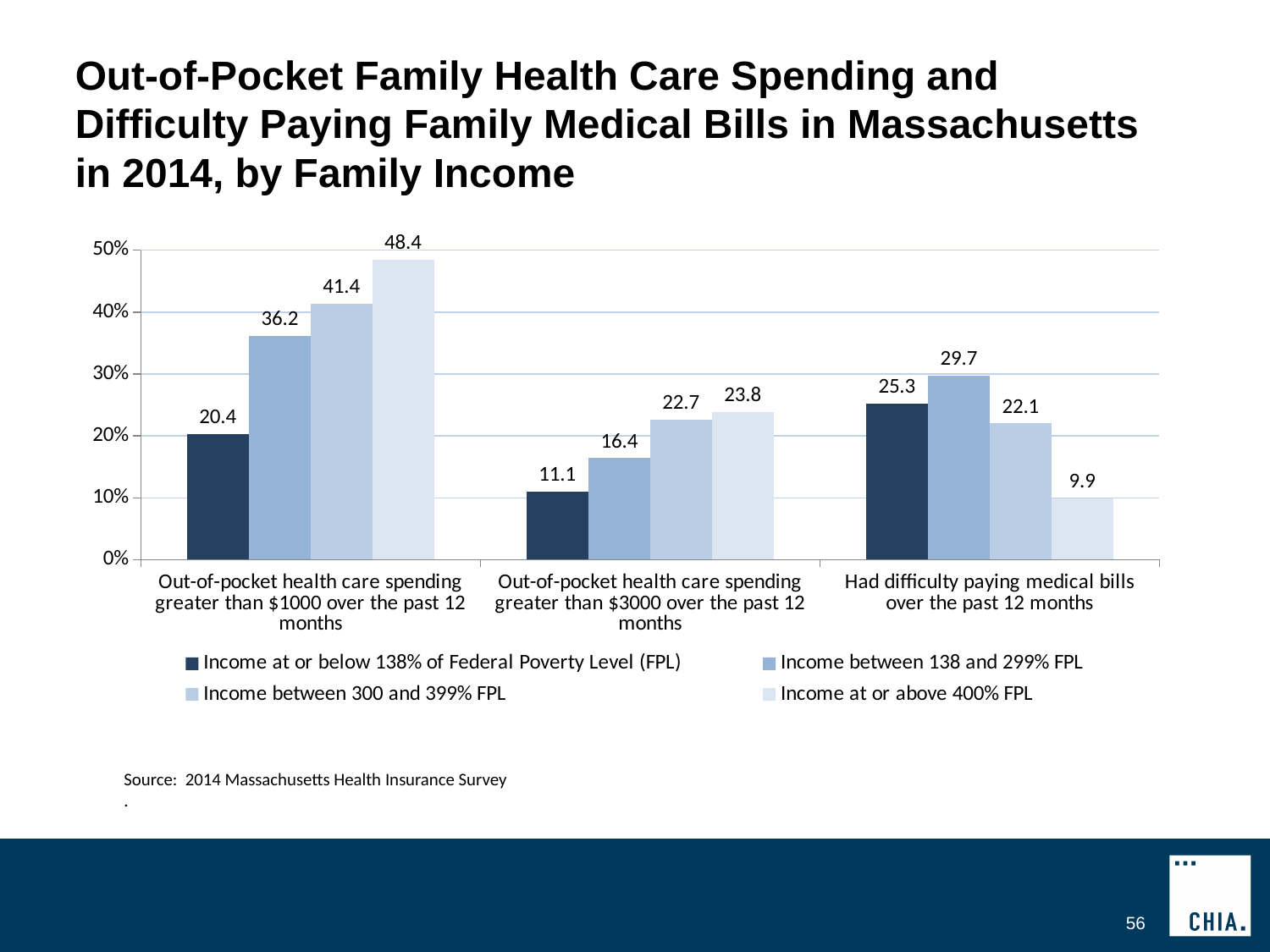
What is the value for families with income at or above 400% FPL for out-of-pocket health care spending greater than $1000 over the past 12 months? 48.4 For having difficulty paying medical bills over the past 12 months, which is larger: the value for income at or below 138% FPL or the value for income between 300 and 399% FPL? Income at or below 138% of Federal Poverty Level (FPL) Which income group has the lowest value for out-of-pocket health care spending greater than $1000 over the past 12 months? Income at or below 138% of Federal Poverty Level (FPL) What kind of chart is shown on the slide? Bar chart What is the difference between the values for income at or above 400% FPL and income at or below 138% FPL for out-of-pocket health care spending greater than $1000 over the past 12 months? 28.0 Is the value for income between 300 and 399% FPL for out-of-pocket health care spending greater than $1000 greater or less than 40%? greater How many series does the legend list? 4 Do the values for out-of-pocket health care spending greater than $3000 rise or fall as family income increases? Rise What is the value for families with income between 138 and 299% FPL for having difficulty paying medical bills over the past 12 months? 29.7 Which income group has the highest value for having difficulty paying medical bills over the past 12 months? Income between 138 and 299% FPL What is the value for families with income at or below 138% of FPL for out-of-pocket health care spending greater than $3000 over the past 12 months? 11.1 How many categories are shown on the x axis? 3